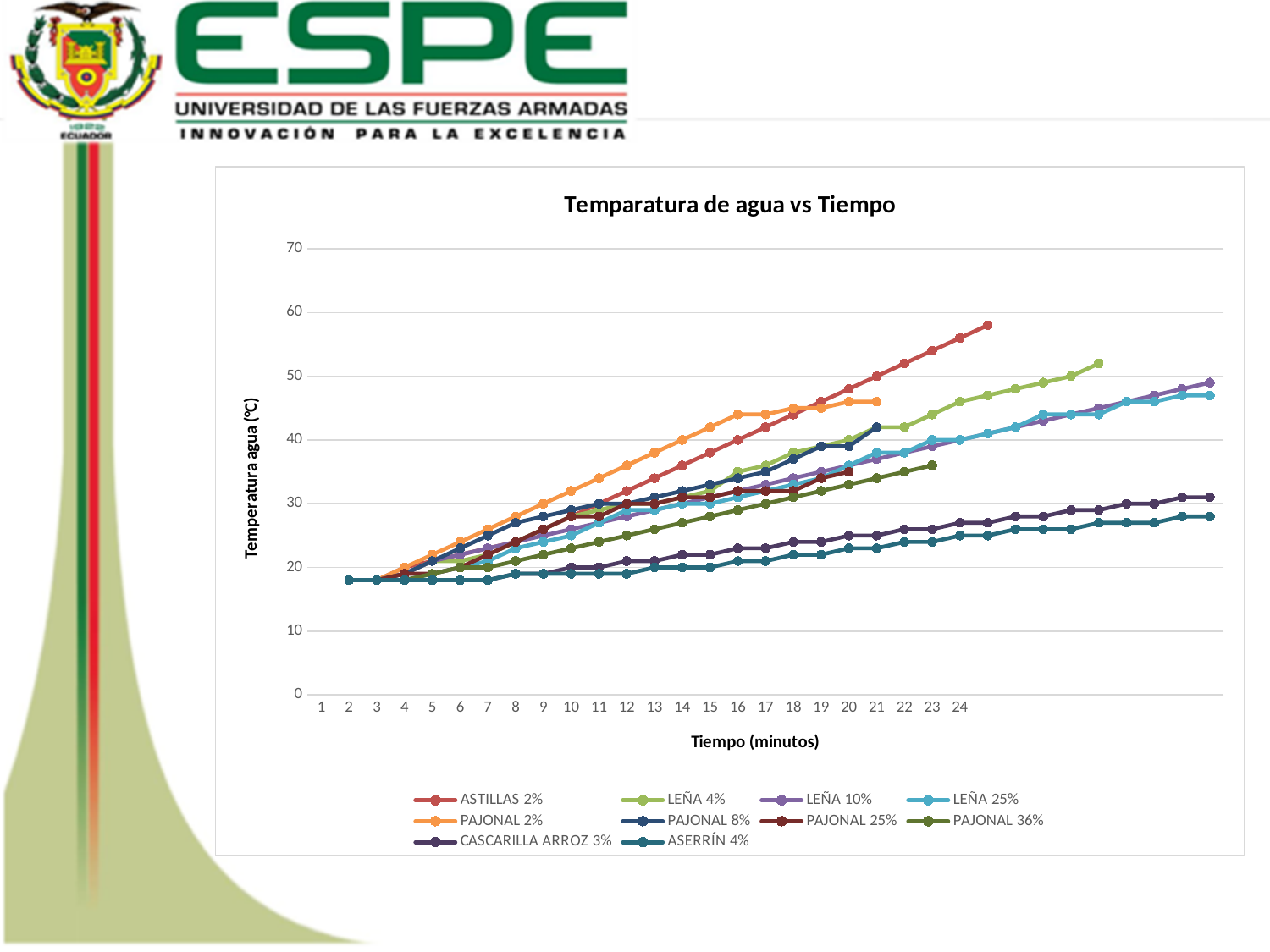
Which series ends at the lowest water temperature at minute 24? ASERRÍN 4% Is the value for ASERRÍN 4% at minute 24 greater or less than 40? less At minute 24, which is larger: the value for LEÑA 10% or the value for CASCARILLA ARROZ 3%? LEÑA 10% Is the value for LEÑA 4% at minute 23 greater or less than 40? greater Is the value for PAJONAL 2% at minute 21 greater or less than 50? less How many series does the legend list? 10 What kind of chart is shown on the slide? line chart What is the title of the chart? Temparatura de agua vs Tiempo Which series reaches the highest water temperature? ASTILLAS 2% What is the label of the vertical axis? Temperatura agua (°C) Do the water temperatures rise or fall as time increases along the x axis? rise